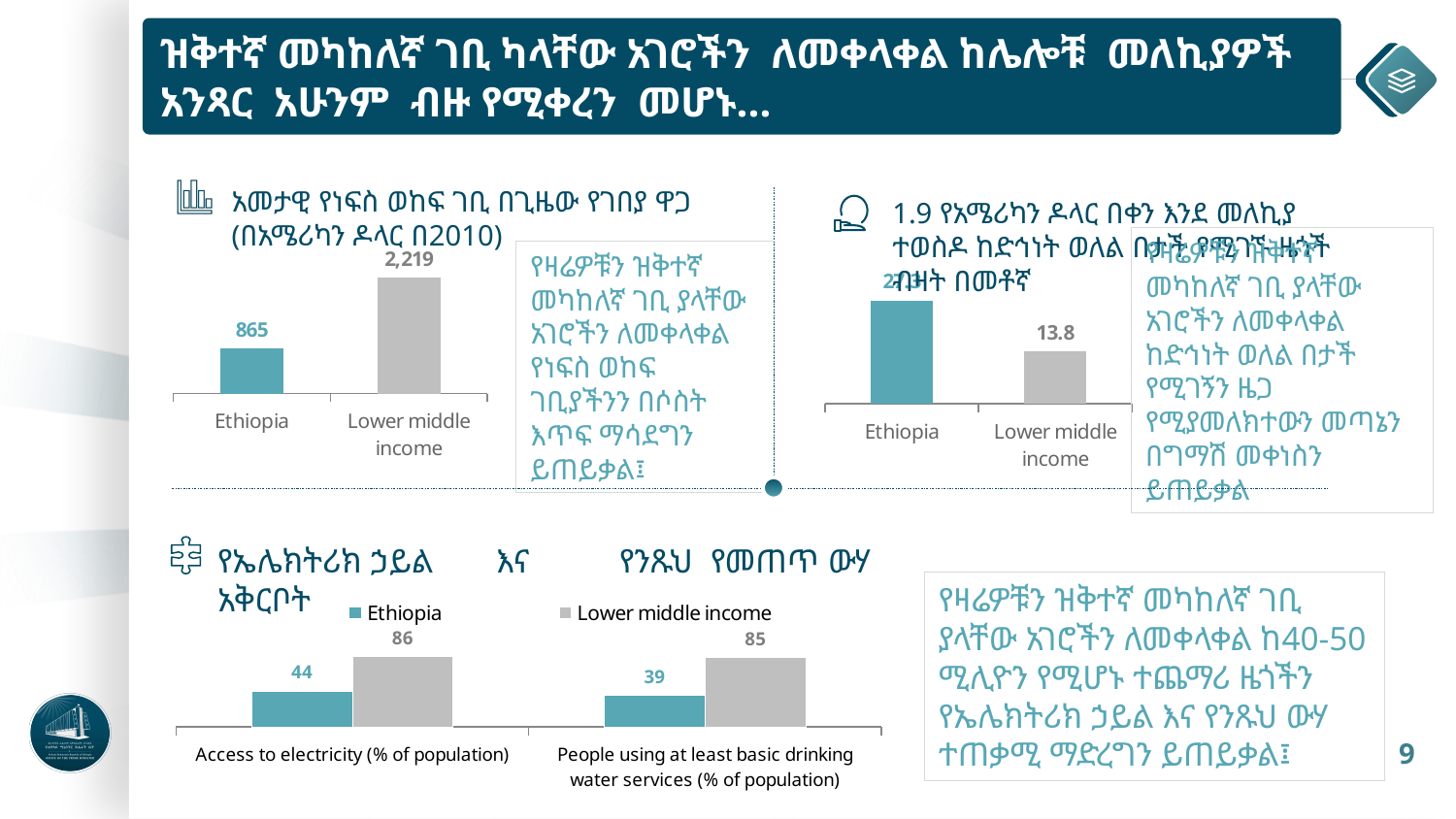
In the top-left chart (annual per capita income), what is the difference between the Lower middle income value and the Ethiopia value? 1,354 What type of chart is the top-left chart (annual per capita income)? Bar chart In the top-right chart (poverty headcount at $1.9 a day), which bar is taller, Ethiopia or Lower middle income? Ethiopia In the bottom chart (electricity and drinking water access), how many series does the legend list? 2 In the bottom chart (electricity and drinking water access), what is the Ethiopia value for Access to electricity (% of population)? 44 In the bottom chart (electricity and drinking water access), what is the difference between the Lower middle income and Ethiopia values for Access to electricity? 42 In the bottom chart (electricity and drinking water access), what is the Lower middle income value for People using at least basic drinking water services (% of population)? 85 In the top-left chart (annual per capita income), which category has the higher value? Lower middle income In the top-right chart (poverty headcount at $1.9 a day), what is the value for Lower middle income? 13.8 In the top-left chart (annual per capita income), what is the value for Ethiopia? 865 In the top-left chart (annual per capita income), what is the value for Lower middle income? 2,219 In the bottom chart (electricity and drinking water access), how many categories are shown on the x axis? 2